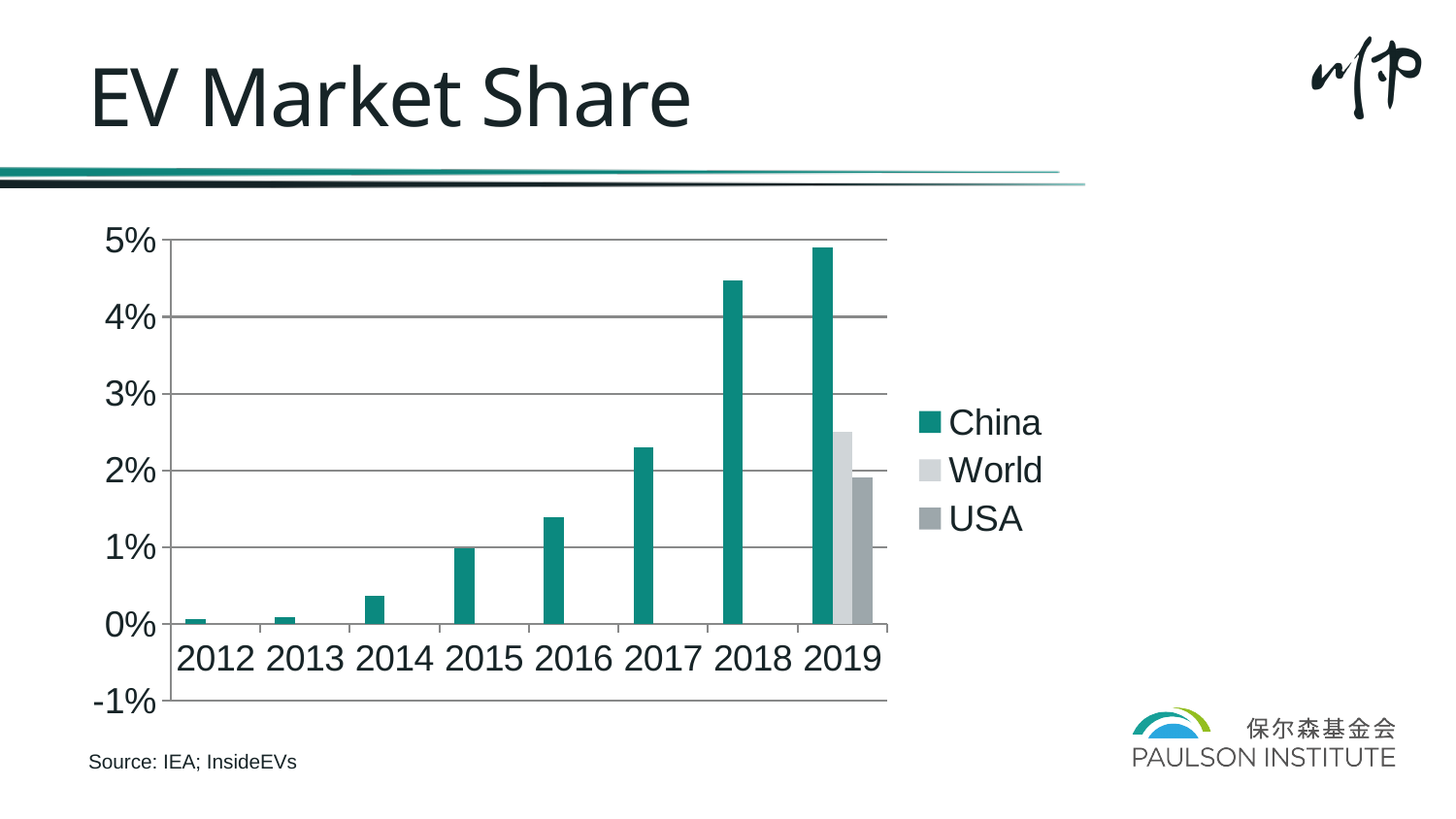
What is the title of the chart? EV Market Share Is the value for China in 2017 greater or less than 2%? greater How many series does the legend list? 3 Is the value for China in 2014 greater or less than 1%? less In 2019, which is larger: the World value or the USA value? World Is the value for World in 2019 greater or less than 2%? greater What kind of chart is shown on the slide? bar chart Does China's EV market share rise or fall from 2012 to 2019? rise How many years are shown on the x axis? 8 In which year is China's EV market share highest? 2019